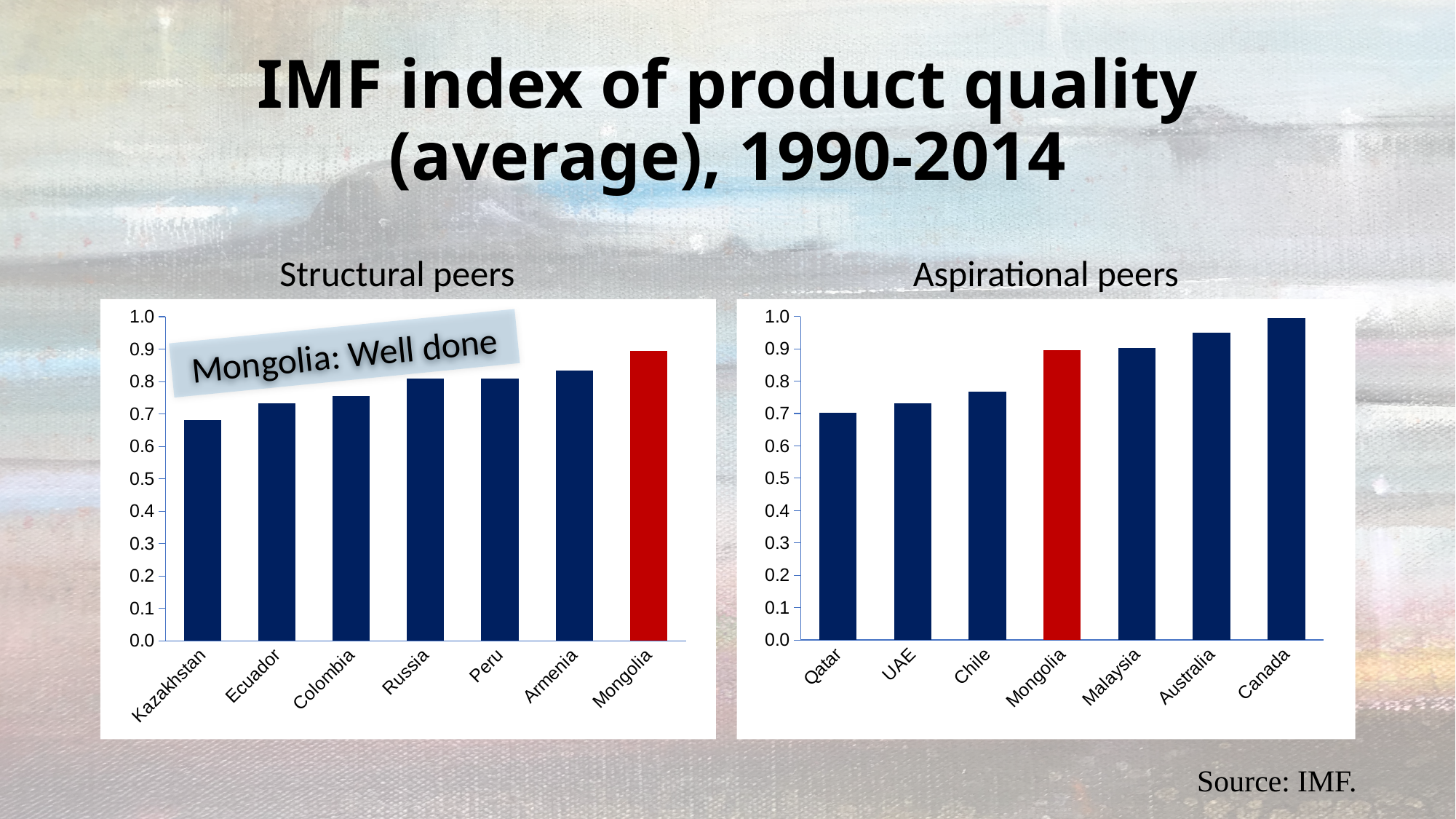
In the Structural peers chart, which country has the lowest value? Kazakhstan In the Structural peers chart, is the value for Mongolia greater or less than 0.8? greater In the Aspirational peers chart, which country has the lowest value? Qatar How many countries are shown in the Aspirational peers chart? 7 In the Aspirational peers chart, which country has the highest value? Canada In the Aspirational peers chart, is the value for Chile greater or less than 0.8? less In the Aspirational peers chart, which is larger, the value for UAE or the value for Canada? Canada In the Structural peers chart, which is larger, the value for Armenia or the value for Ecuador? Armenia In the Aspirational peers chart, is the value for Australia greater or less than 0.9? greater In the Structural peers chart, which country has the highest value? Mongolia What type of chart is the Structural peers chart? Bar chart